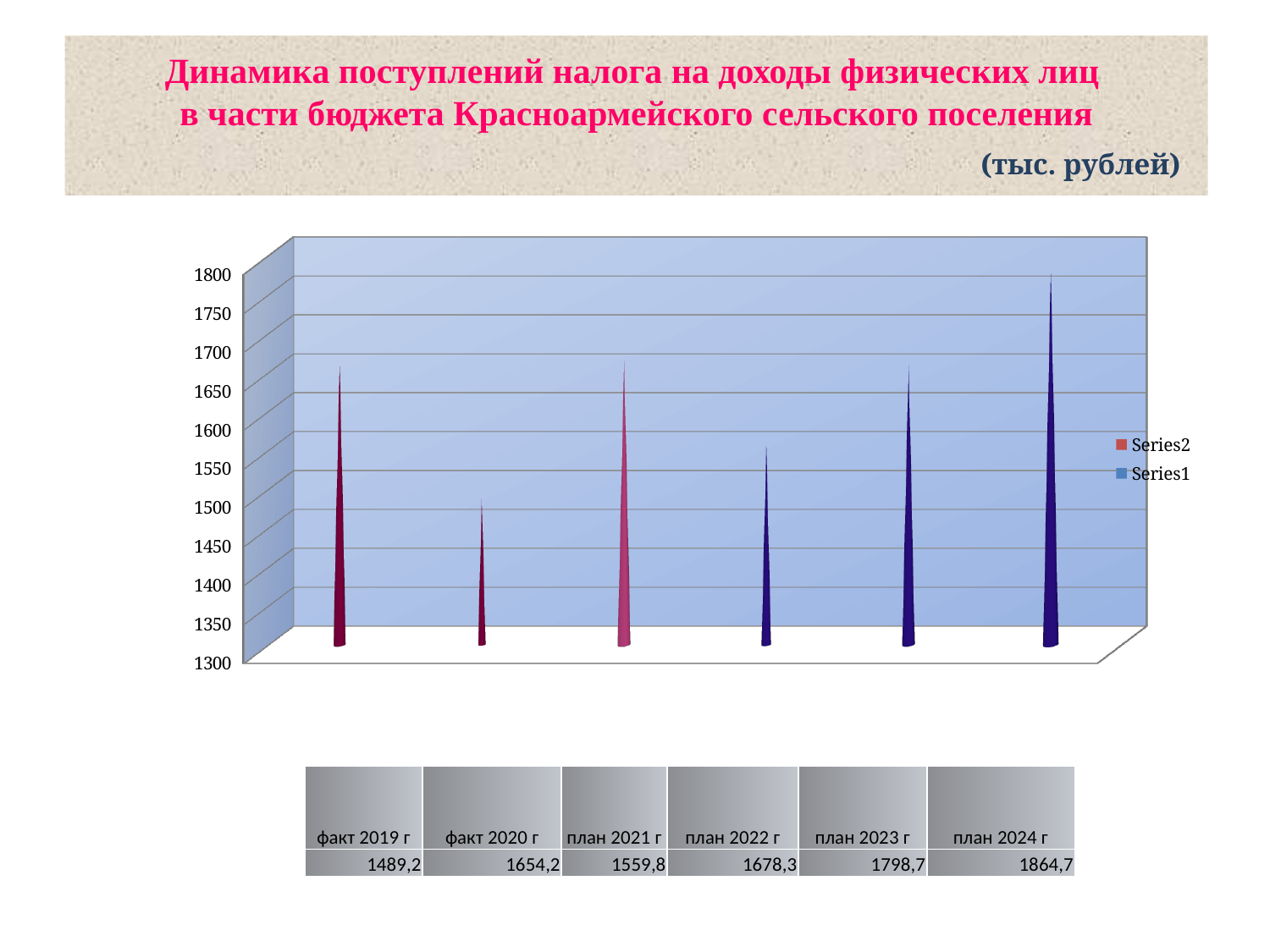
What is the value for факт 2019 г? 1489,2 What is the value for план 2024 г? 1864,7 How many categories are shown on the chart? 6 What kind of chart is shown on the slide? bar chart What is the difference between the values for план 2023 г and план 2022 г? 120,4 In what units are the values on the slide given? тыс. рублей What is the value for план 2022 г? 1678,3 Which is larger, the value for план 2023 г or план 2022 г? план 2023 г What is the difference between the values for план 2024 г and факт 2019 г? 375,5 How many series does the legend list? 2 Which category has the highest value? план 2024 г What is the value for план 2023 г? 1798,7